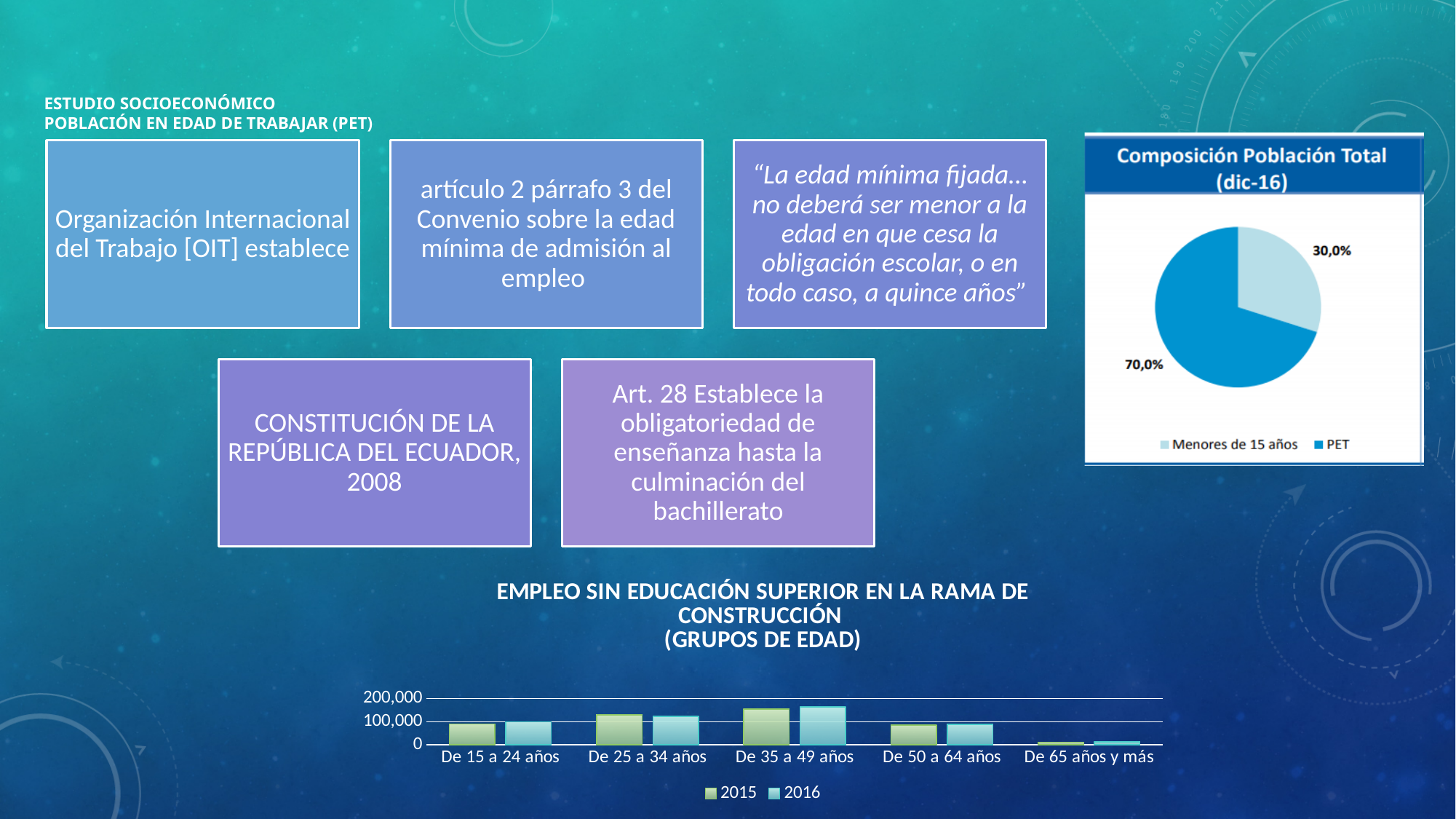
In the bar chart 'Empleo sin educación superior en la rama de construcción', is the 2016 value for De 65 años y más greater or less than 100,000? less In the pie chart 'Composición Población Total (dic-16)', what percentage is shown for PET? 70,0% What kind of chart is 'Empleo sin educación superior en la rama de construcción (grupos de edad)'? Bar chart What kind of chart is 'Composición Población Total (dic-16)'? Pie chart In the pie chart 'Composición Población Total (dic-16)', which slice is larger, PET or Menores de 15 años? PET In the bar chart 'Empleo sin educación superior en la rama de construcción', which age group has the highest value for 2015? De 35 a 49 años In the bar chart 'Empleo sin educación superior en la rama de construcción', which age group has the lowest value for 2016? De 65 años y más In the bar chart 'Empleo sin educación superior en la rama de construcción', is the 2015 value for De 35 a 49 años greater or less than 100,000? greater In the bar chart 'Empleo sin educación superior en la rama de construcción', how many age groups are shown on the x axis? 5 In the pie chart 'Composición Población Total (dic-16)', how many slices does the pie have? 2 In the bar chart 'Empleo sin educación superior en la rama de construcción', how many series does the legend list? 2 In the pie chart 'Composición Población Total (dic-16)', what percentage is shown for Menores de 15 años? 30,0%